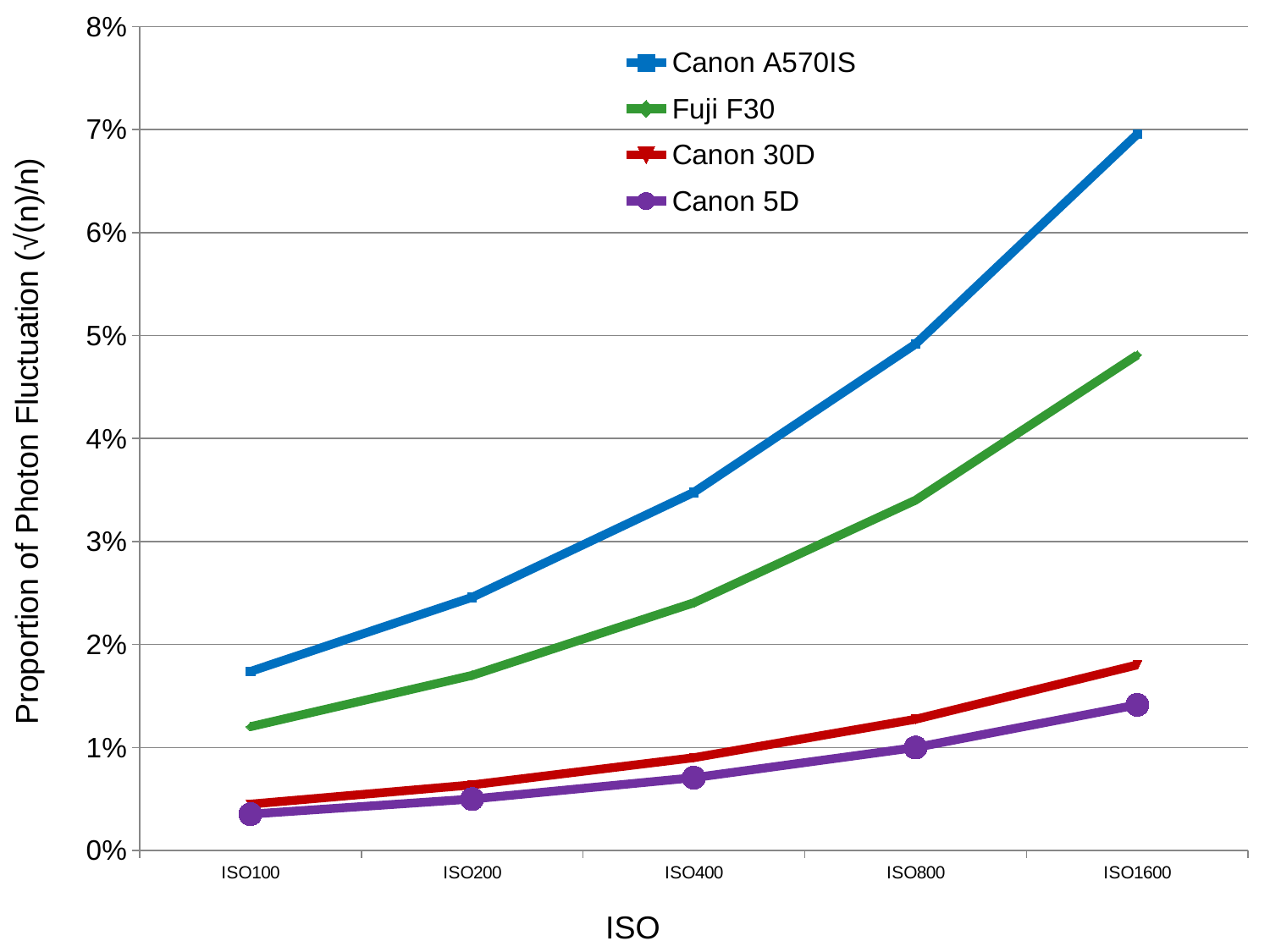
Which series has the lowest value at ISO1600? Canon 5D What is the title of the x axis? ISO Is the value for Canon A570IS at ISO1600 greater or less than 6%? greater Which is larger at ISO800, the value for Fuji F30 or the value for Canon 30D? Fuji F30 Is the value for Canon 5D at ISO400 greater or less than 1%? less How many series does the legend list? 4 What kind of chart is shown on the slide? line chart How many ISO categories are shown on the x axis? 5 Which series has the highest value at ISO1600? Canon A570IS Is the value for Fuji F30 at ISO800 greater or less than 3%? greater Do the values for Canon A570IS rise or fall as ISO increases from ISO100 to ISO1600? rise